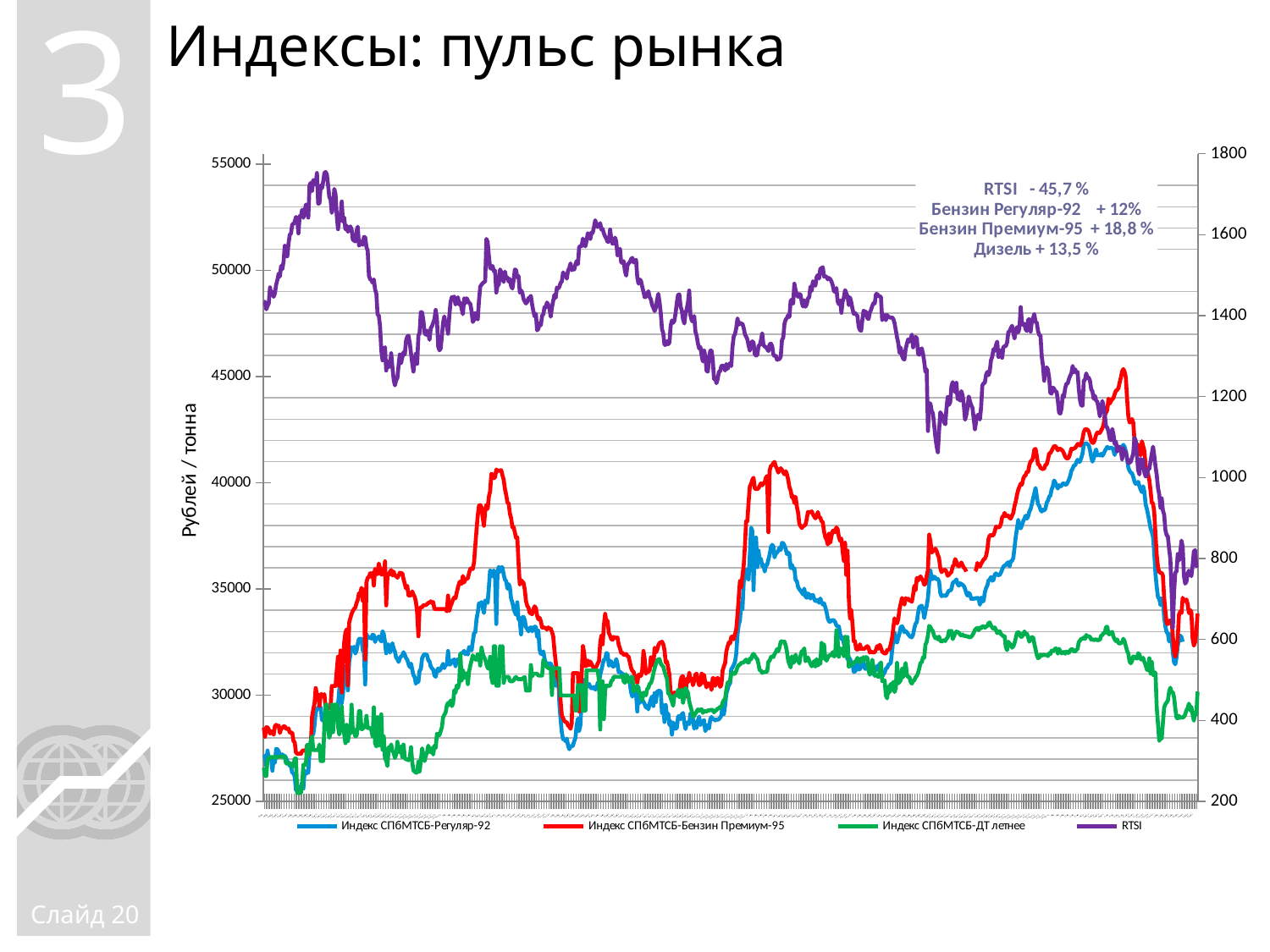
Is the highest value reached by the Индекс СПбМТСБ-ДТ летнее line greater or less than 35000 on the left axis? less Does the RTSI line overall rise or fall from the left to the right of the chart? fall What percentage change is shown for Бензин Регуляр-92 in the annotation on the chart? + 12% Which series is plotted in purple according to the legend? RTSI What percentage change is shown for Бензин Премиум-95 in the annotation on the chart? + 18,8 % Which of the three fuel index series reaches the highest value on the left axis? Индекс СПбМТСБ-Бензин Премиум-95 What percentage change is shown for RTSI in the annotation on the chart? - 45,7 % What percentage change is shown for Дизель in the annotation on the chart? + 13,5 % What is the title of the left vertical axis? Рублей / тонна What kind of chart is shown on the slide? line chart Is the highest value reached by the RTSI line greater or less than 1600 on the right axis? greater How many series does the legend list? 4